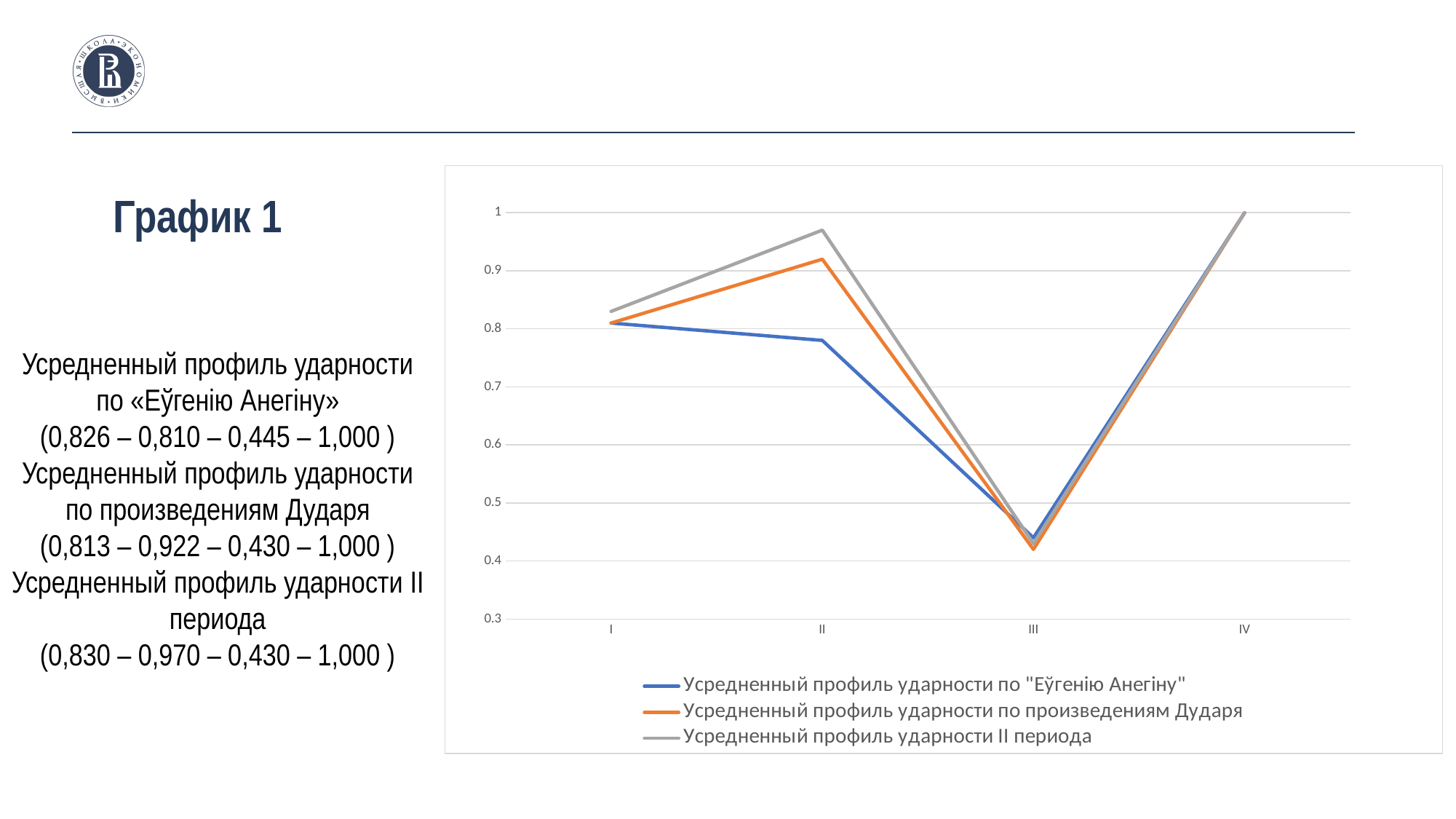
At which category does the series "Усредненный профиль ударности по произведениям Дударя" reach its lowest value? III At category II, which series has the larger value: "Усредненный профиль ударности по произведениям Дударя" or "Усредненный профиль ударности по "Еўгенію Анегіну""? Усредненный профиль ударности по произведениям Дударя Is the value for "Усредненный профиль ударности II периода" at category II greater or less than 0.9? greater At which category does the series "Усредненный профиль ударности II периода" reach its highest value? IV How many series does the legend list? 3 What is the title of the chart given on the slide? График 1 What is the value of the series "Усредненный профиль ударности II периода" at category IV? 1 Is the value for "Усредненный профиль ударности по произведениям Дударя" at category III greater or less than 0.5? less Do the values of the series "Усредненный профиль ударности II периода" rise or fall from category II to category III? fall How many categories are on the x axis? 4 What kind of chart is shown on the slide? line chart Is the value for "Усредненный профиль ударности по "Еўгенію Анегіну"" at category II greater or less than 0.8? less